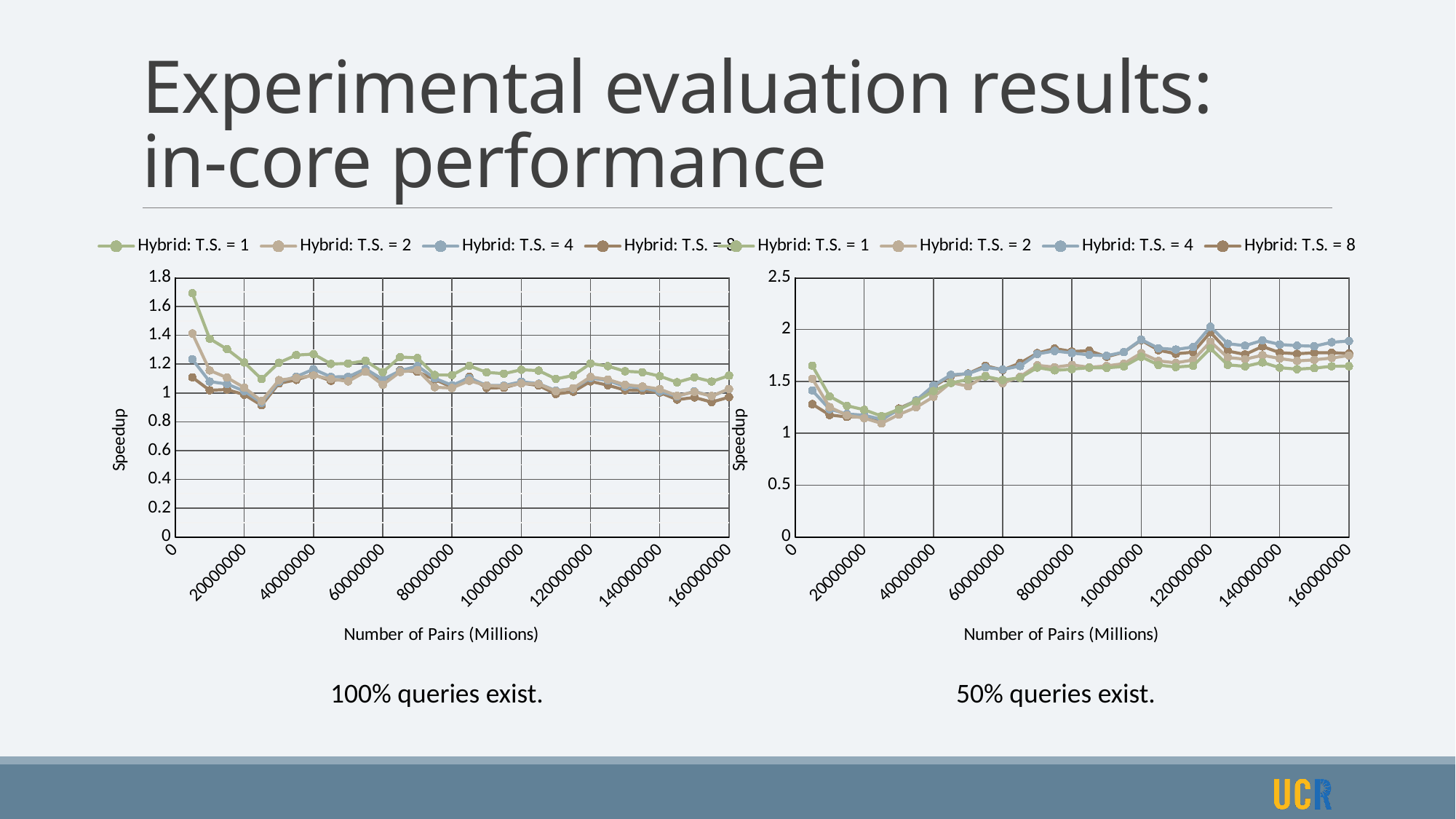
In the left chart (100% queries exist), which series has the highest value at the first data point? Hybrid: T.S. = 1 In the right chart (50% queries exist), is the value for Hybrid: T.S. = 1 at 160000000 greater or less than 2? less In the right chart (50% queries exist), is the first value for Hybrid: T.S. = 1 greater or less than 1.5? greater In the left chart (100% queries exist), is the first value for Hybrid: T.S. = 1 greater or less than 1.6? greater In the left chart (100% queries exist), at the first data point, which is larger: Hybrid: T.S. = 1 or Hybrid: T.S. = 8? Hybrid: T.S. = 1 What is the y-axis title of the left chart (100% queries exist)? Speedup What kind of chart is the left chart (100% queries exist)? line chart What is the x-axis title of the right chart (50% queries exist)? Number of Pairs (Millions) In the right chart (50% queries exist), which series has the highest value at 160000000? Hybrid: T.S. = 4 In the right chart (50% queries exist), does the Hybrid: T.S. = 4 series generally rise or fall from 20000000 to 160000000 pairs? rise How many series does the legend of the right chart (50% queries exist) list? 4